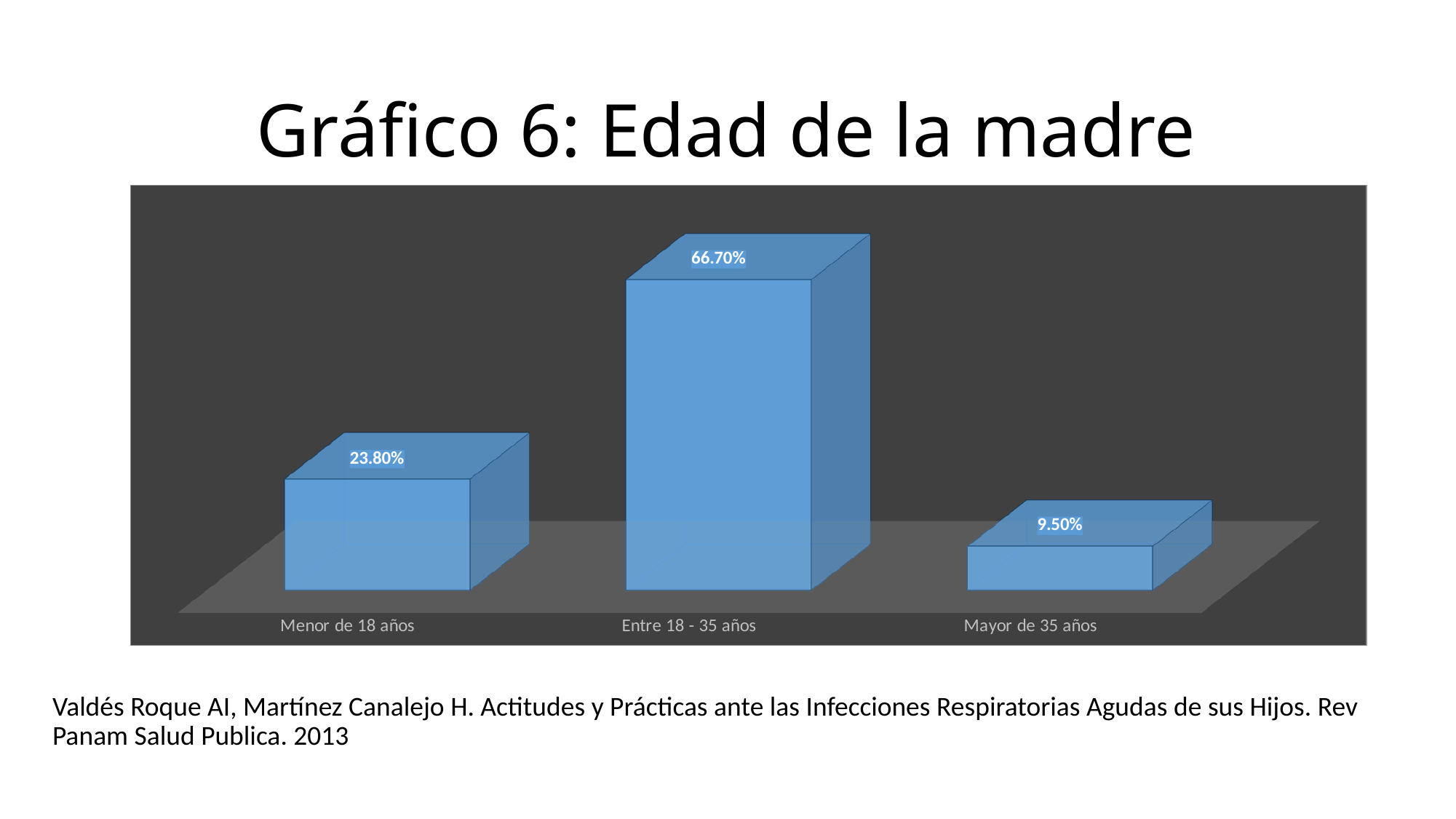
What kind of chart is shown on the slide? Bar chart What is the value for "Menor de 18 años"? 23.80% Which category has the highest value? Entre 18 - 35 años What is the value for "Entre 18 - 35 años"? 66.70% How many categories are shown in the chart? 3 Which category has the lowest value? Mayor de 35 años What is the difference between the values for "Entre 18 - 35 años" and "Menor de 18 años"? 42.90% What is the difference between the values for "Menor de 18 años" and "Mayor de 35 años"? 14.30% Which is larger, the value for "Menor de 18 años" or the value for "Mayor de 35 años"? Menor de 18 años What is the title of the slide? Gráfico 6: Edad de la madre What is the value for "Mayor de 35 años"? 9.50% What colour are the bars in the chart? Blue